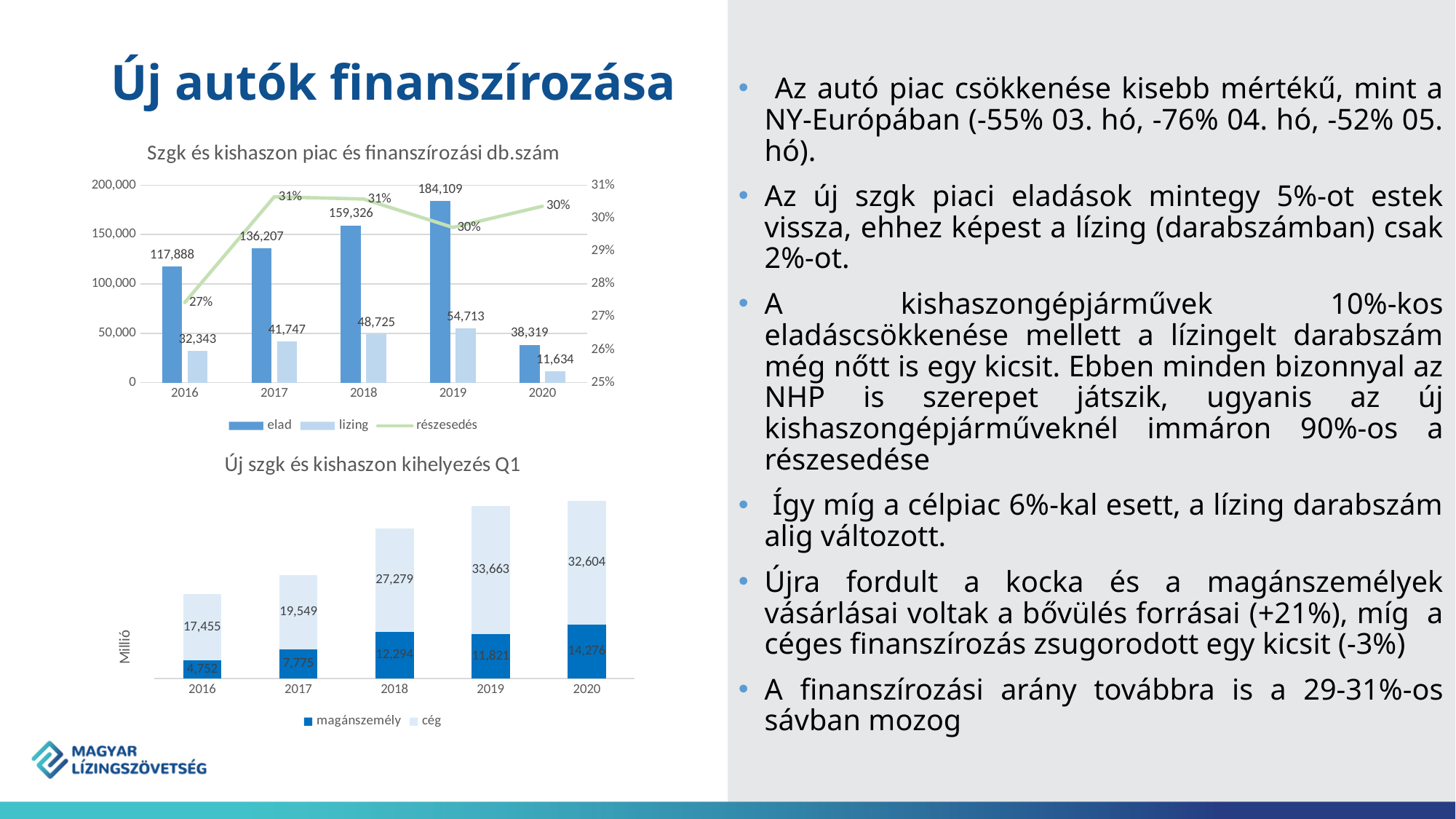
What kind of chart is the one titled "Új szgk és kishaszon kihelyezés Q1"? Stacked bar chart In the chart titled "Szgk és kishaszon piac és finanszírozási db.szám", which year has the lowest elad value? 2020 In the chart titled "Szgk és kishaszon piac és finanszírozási db.szám", how many series does the legend list? 3 In the chart titled "Új szgk és kishaszon kihelyezés Q1", how many years are shown on the x axis? 5 In the chart titled "Szgk és kishaszon piac és finanszírozási db.szám", what is the value of lizing for 2018? 48,725 In the chart titled "Új szgk és kishaszon kihelyezés Q1", what is the cég value for 2019? 33,663 In the chart titled "Új szgk és kishaszon kihelyezés Q1", what is the total of the stacked bar for 2020? 46,880 In the chart titled "Új szgk és kishaszon kihelyezés Q1", which year has the highest magánszemély value? 2020 In the chart titled "Szgk és kishaszon piac és finanszírozási db.szám", is the lizing value for 2017 greater or less than 50,000? less In the chart titled "Szgk és kishaszon piac és finanszírozási db.szám", what is the részesedés value for 2016? 27% In the chart titled "Szgk és kishaszon piac és finanszírozási db.szám", what is the value of elad for 2019? 184,109 In the chart titled "Szgk és kishaszon piac és finanszírozási db.szám", what is the difference between the elad values for 2019 and 2020? 145,790